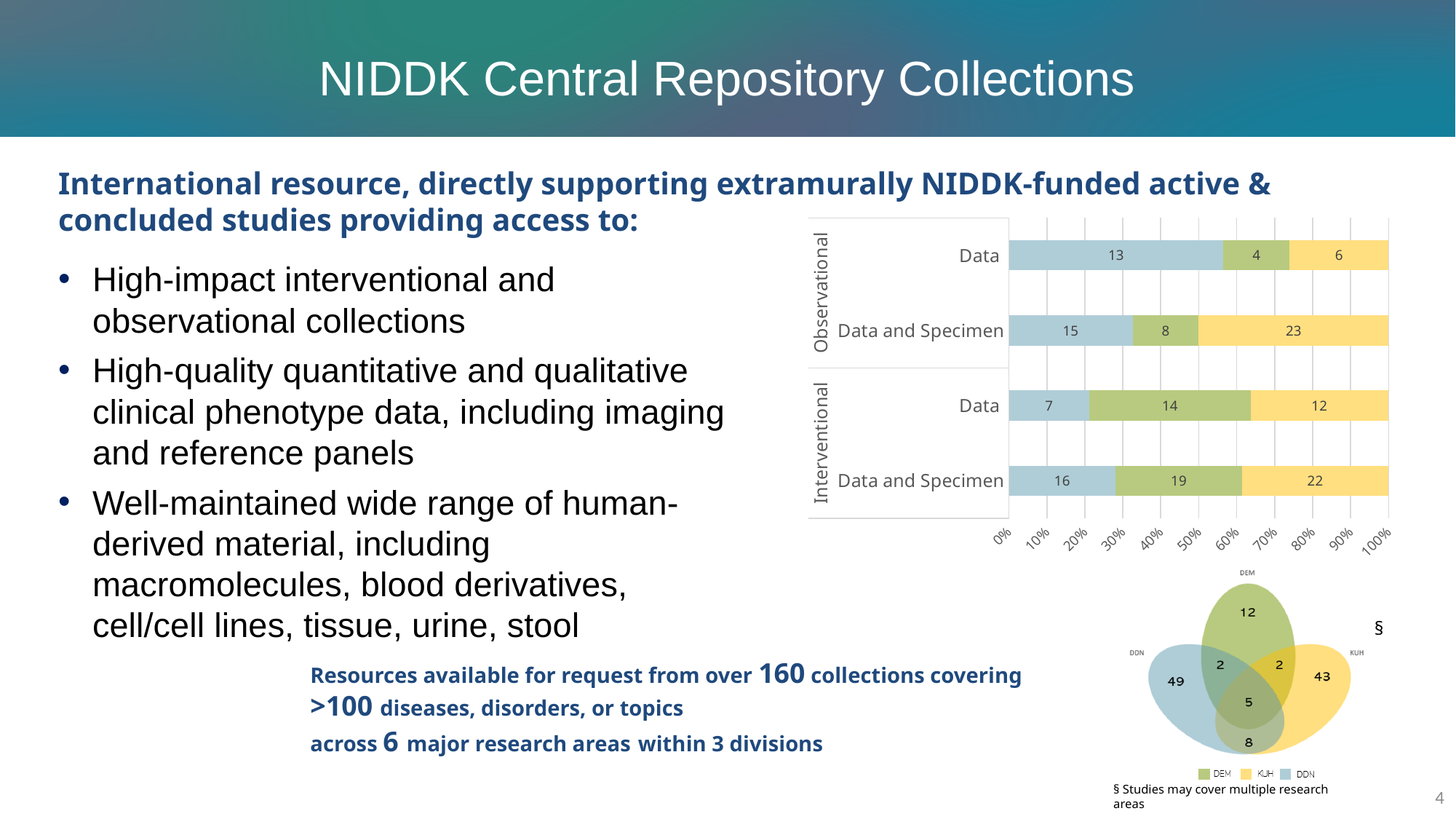
In the stacked bar chart, which bar has the largest total across its three segments? Interventional 'Data and Specimen' In the stacked bar chart, what value is printed on the blue segment of the Observational 'Data' bar? 13 In the stacked bar chart, what value is printed on the green segment of the Interventional 'Data' bar? 14 How many bars are shown in the stacked bar chart? 4 In the Venn diagram, what number is shown in the DDN-only region? 49 In the stacked bar chart, which bar has the larger green segment value: Interventional 'Data' or Observational 'Data'? Interventional 'Data' In the stacked bar chart, what is the total of the three segments in the Observational 'Data and Specimen' bar? 46 In the stacked bar chart, what is the total of the three segments in the Interventional 'Data' bar? 33 In the stacked bar chart, what value is printed on the yellow segment of the Interventional 'Data and Specimen' bar? 22 In the Venn diagram, what number is shown where all three circles (DEM, KUH, DDN) overlap? 5 What kind of chart is the chart at the top right of the slide? Stacked bar chart In the stacked bar chart, what is the difference between the yellow segment of the Observational 'Data and Specimen' bar and the yellow segment of the Observational 'Data' bar? 17